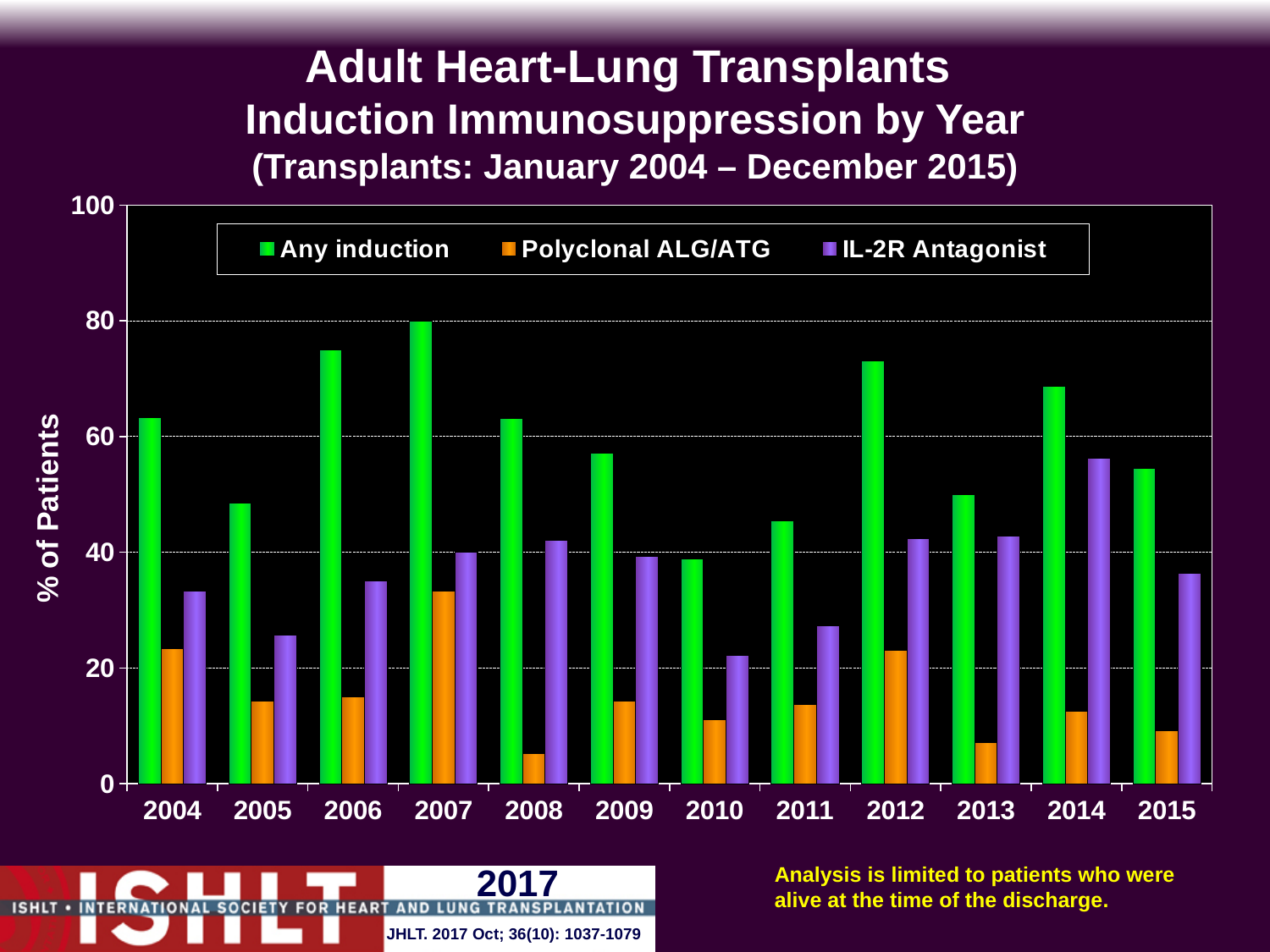
In which year is the Any induction value lowest? 2010 Is the Polyclonal ALG/ATG value for 2008 greater or less than 20? less In which year is the Polyclonal ALG/ATG value highest? 2007 How many years are shown on the x axis? 12 In which year is the IL-2R Antagonist value highest? 2014 Is the Any induction value for 2007 greater or less than 60? greater What kind of chart is shown on the slide? bar chart How many series does the legend list? 3 Is the IL-2R Antagonist value for 2014 greater or less than 40? greater Which is larger, the Any induction value for 2005 or for 2006? 2006 What is the label of the y axis? % of Patients In which year is the Any induction value highest? 2007